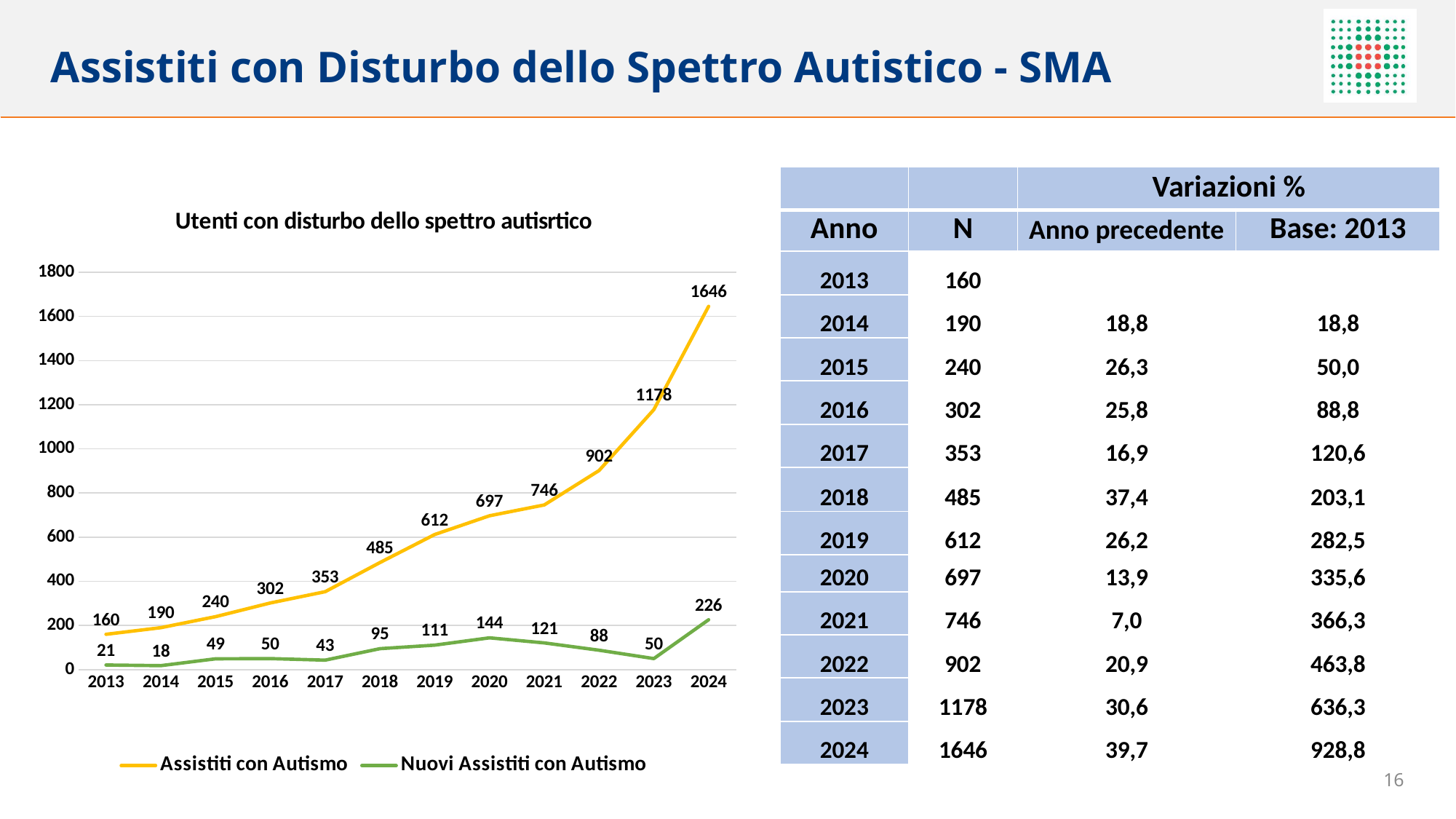
In which year is Nuovi Assistiti con Autismo lowest? 2014 What is the value for Assistiti con Autismo in 2018? 485 How many series does the chart legend list? 2 Which is larger: Nuovi Assistiti con Autismo in 2021 or in 2022? 2021 What is the value for Assistiti con Autismo in 2024? 1646 Does the Assistiti con Autismo series rise or fall from 2013 to 2024? Rise What colour is the line for Nuovi Assistiti con Autismo? Green How many years are shown on the x axis of the chart? 12 In which year is Assistiti con Autismo highest? 2024 What kind of chart is shown on the slide? Line chart What is the value for Nuovi Assistiti con Autismo in 2020? 144 What is the difference between Assistiti con Autismo in 2024 and in 2023? 468